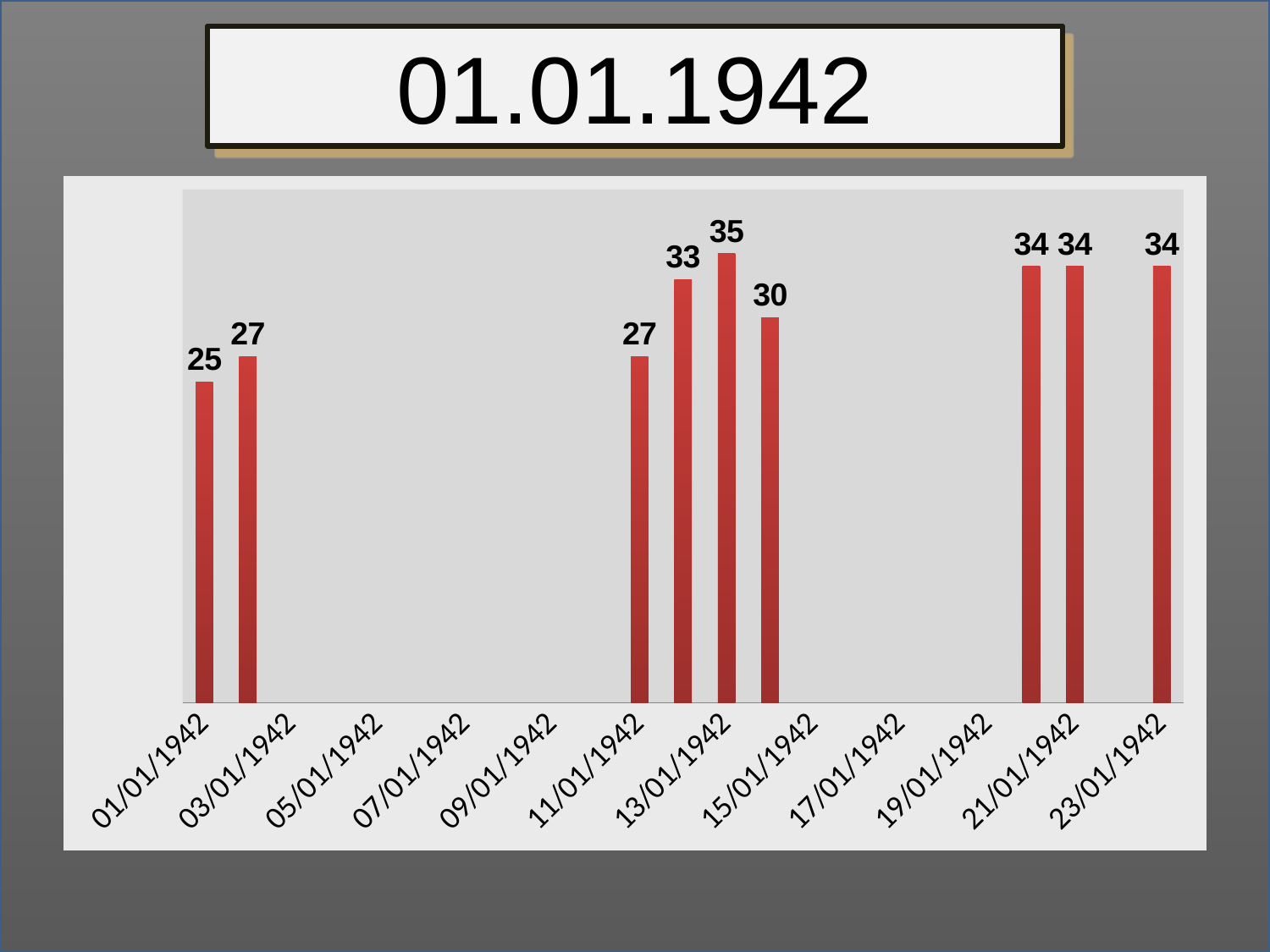
What is the title shown above the chart? 01.01.1942 What is the lowest value shown in the chart? 25 What is the value of the bar at 01/01/1942? 25 What is the highest value shown in the chart? 35 Do the values rise or fall from 11/01/1942 to 13/01/1942? rise What is the difference between the value at 13/01/1942 and the value at 01/01/1942? 10 What is the value of the bar at 13/01/1942? 35 Which is larger, the value at 11/01/1942 or the value at 23/01/1942? 23/01/1942 What is the value of the bar at 23/01/1942? 34 What is the value of the bar at 11/01/1942? 27 What type of chart is shown on the slide? bar chart How many bars are plotted in the chart? 9